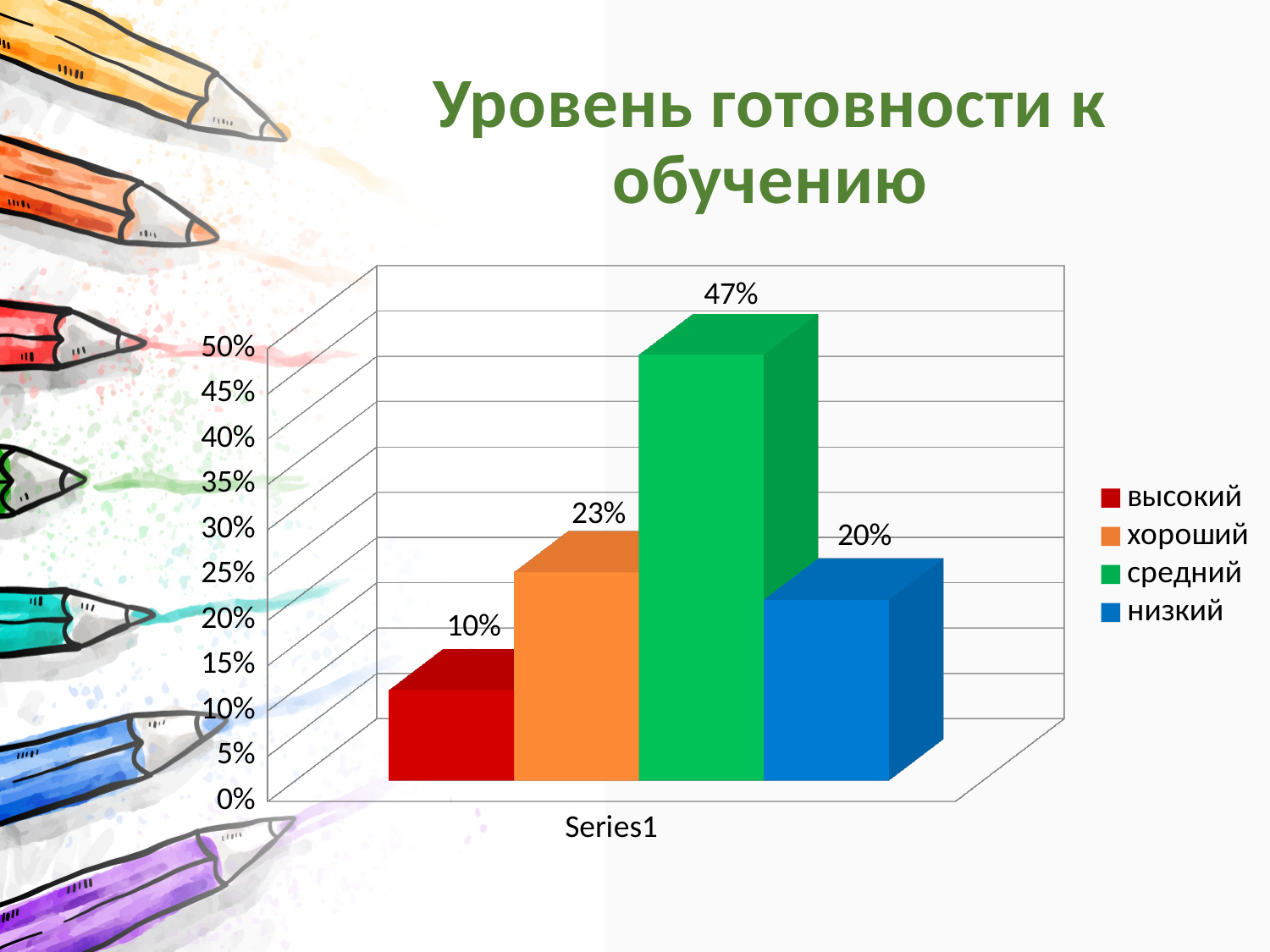
Which category has the highest value? средний What is the value for низкий? 20% Which category has the lowest value? высокий What is the value for высокий? 10% How many series does the legend list? 4 What is the value for средний? 47% Which is larger, the value for хороший or the value for низкий? хороший What is the difference between the values for средний and хороший? 24% What is the value for хороший? 23% What colour is the bar for средний? green What is the title of the slide? Уровень готовности к обучению What kind of chart is shown on the slide? bar chart